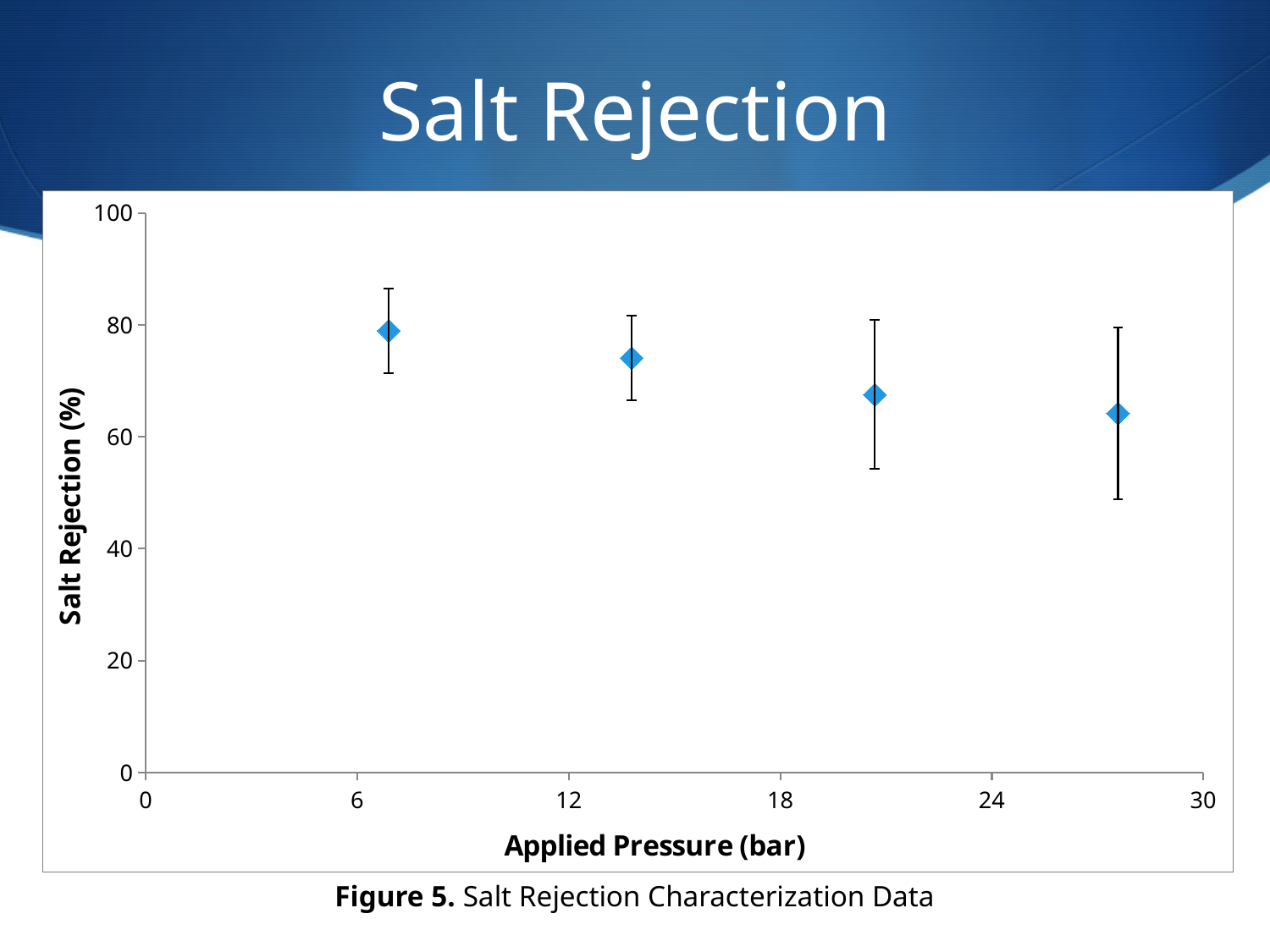
Is the salt rejection value for the rightmost data point greater or less than 80? less Which is larger: the salt rejection value of the leftmost point or the rightmost point? the leftmost point Which data point has the lowest salt rejection value? the rightmost point What kind of chart is shown on the slide? scatter chart Is the salt rejection value for the third data point from the left greater or less than 60? greater Is the salt rejection value for the second data point from the left greater or less than 80? less Do the salt rejection values rise or fall as applied pressure increases along the x axis? fall What is the label of the x axis? Applied Pressure (bar) What is the label of the y axis? Salt Rejection (%) Which data point has the highest salt rejection: the leftmost point or the rightmost point? the leftmost point How many data points are plotted on the chart? 4